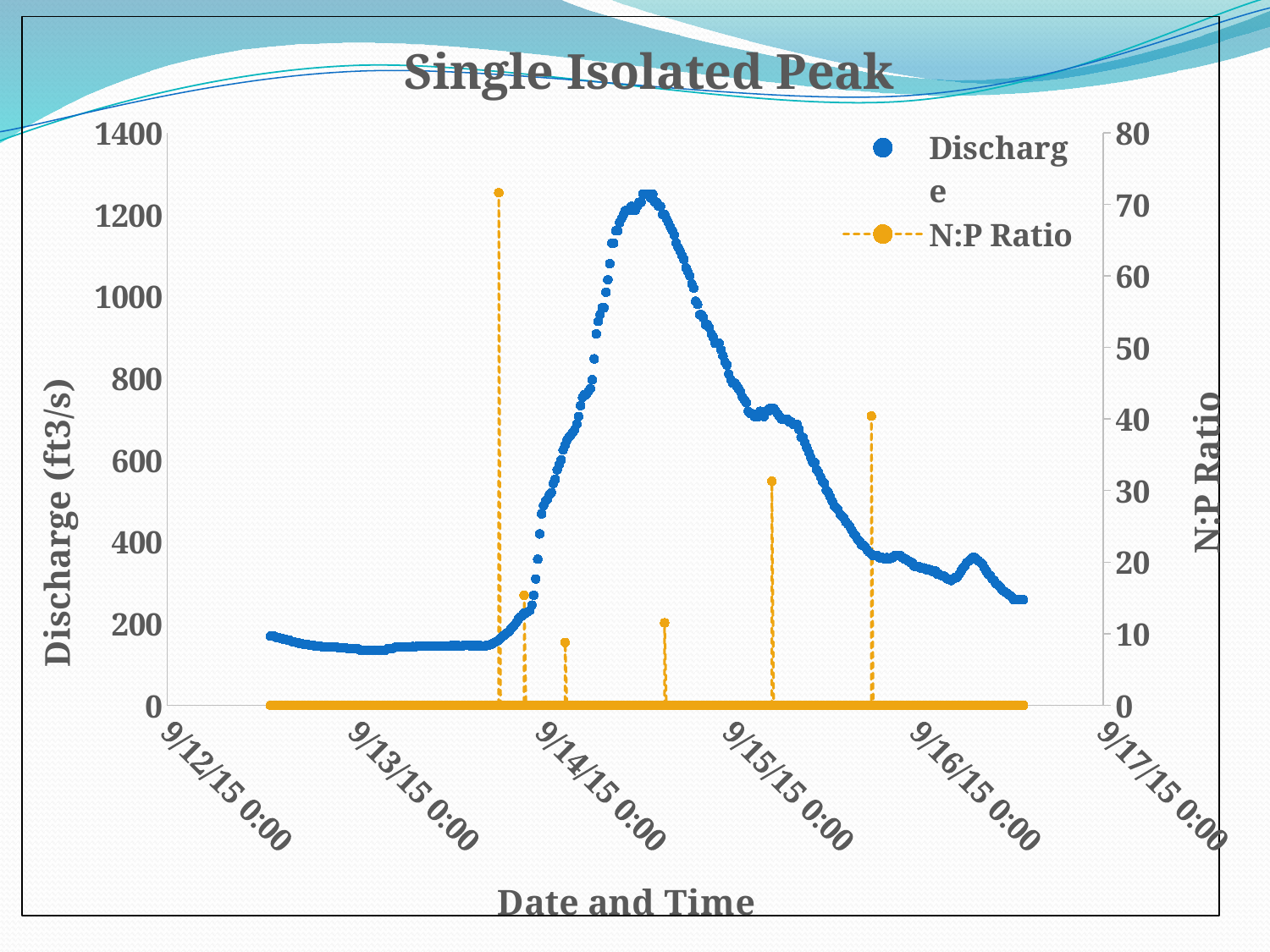
Is the Discharge value at the end of the record (before 9/17/15 0:00) greater or less than 200? greater How many nonzero N:P Ratio spikes are plotted? 6 Is the N:P Ratio spike just before 9/16/15 0:00 greater or less than 30? greater What is the title of the chart? Single Isolated Peak Is the Discharge value at the start of the record (just after 9/12/15 0:00) greater or less than 200? less Does Discharge rise or fall between 9/15/15 0:00 and 9/16/15 0:00? fall What kind of chart is shown on the slide? scatter chart Does Discharge rise or fall between 9/13/15 0:00 and 9/14/15 0:00? rise How many series does the legend list? 2 Which series is plotted against the right-hand axis? N:P Ratio